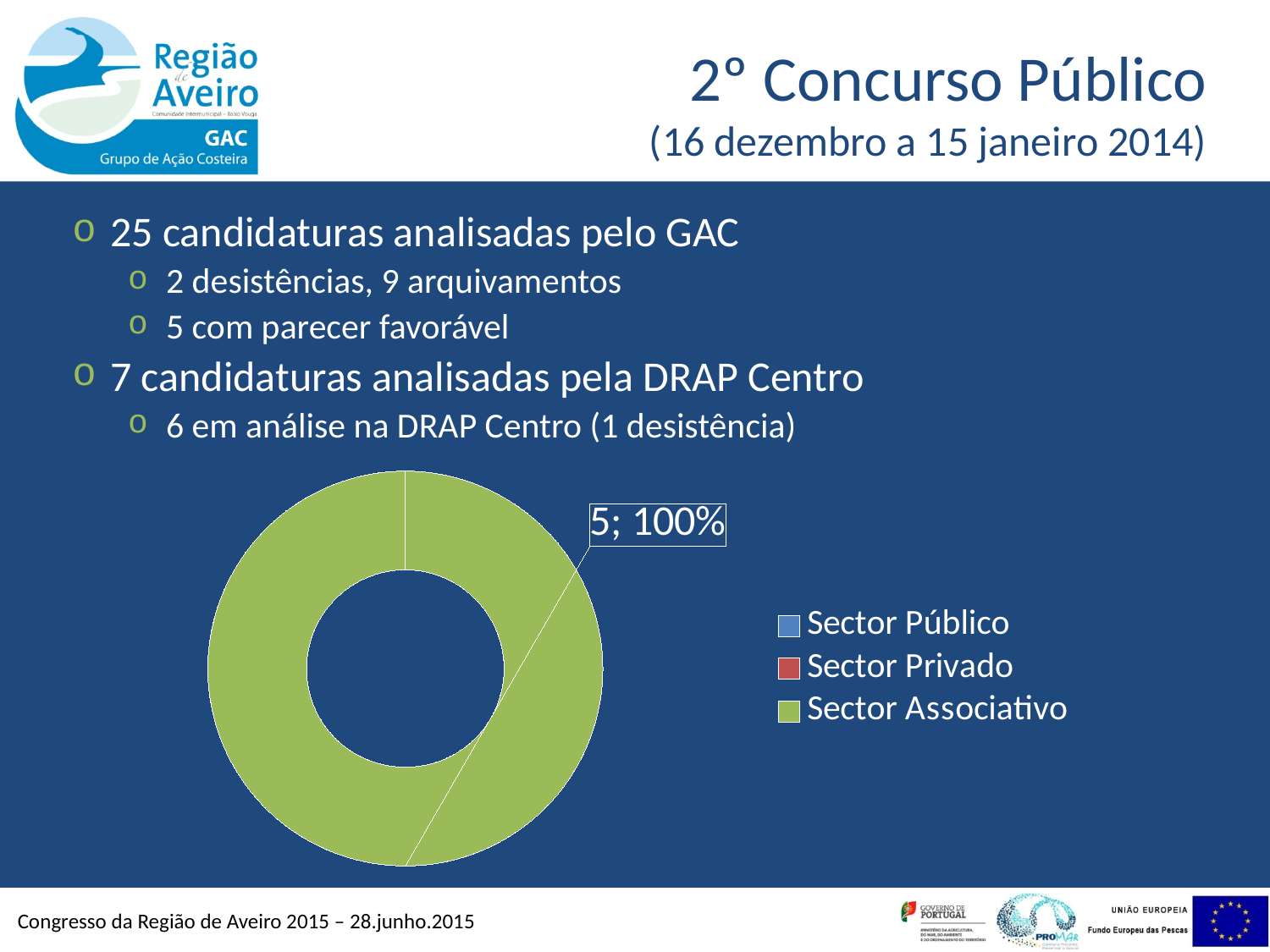
What kind of chart is shown on the slide? Doughnut chart How many slices are visible in the doughnut chart? 1 What value is shown on the data label for the Sector Associativo slice? 5 What is the full text of the data label shown on the chart? 5; 100% What are the three legend entries of the chart? Sector Público, Sector Privado, Sector Associativo Which sector accounts for the largest share of the chart? Sector Associativo What share of the doughnut does the Sector Associativo slice represent? 100% How many entries does the chart legend list? 3 Which legend entry is shown in green? Sector Associativo